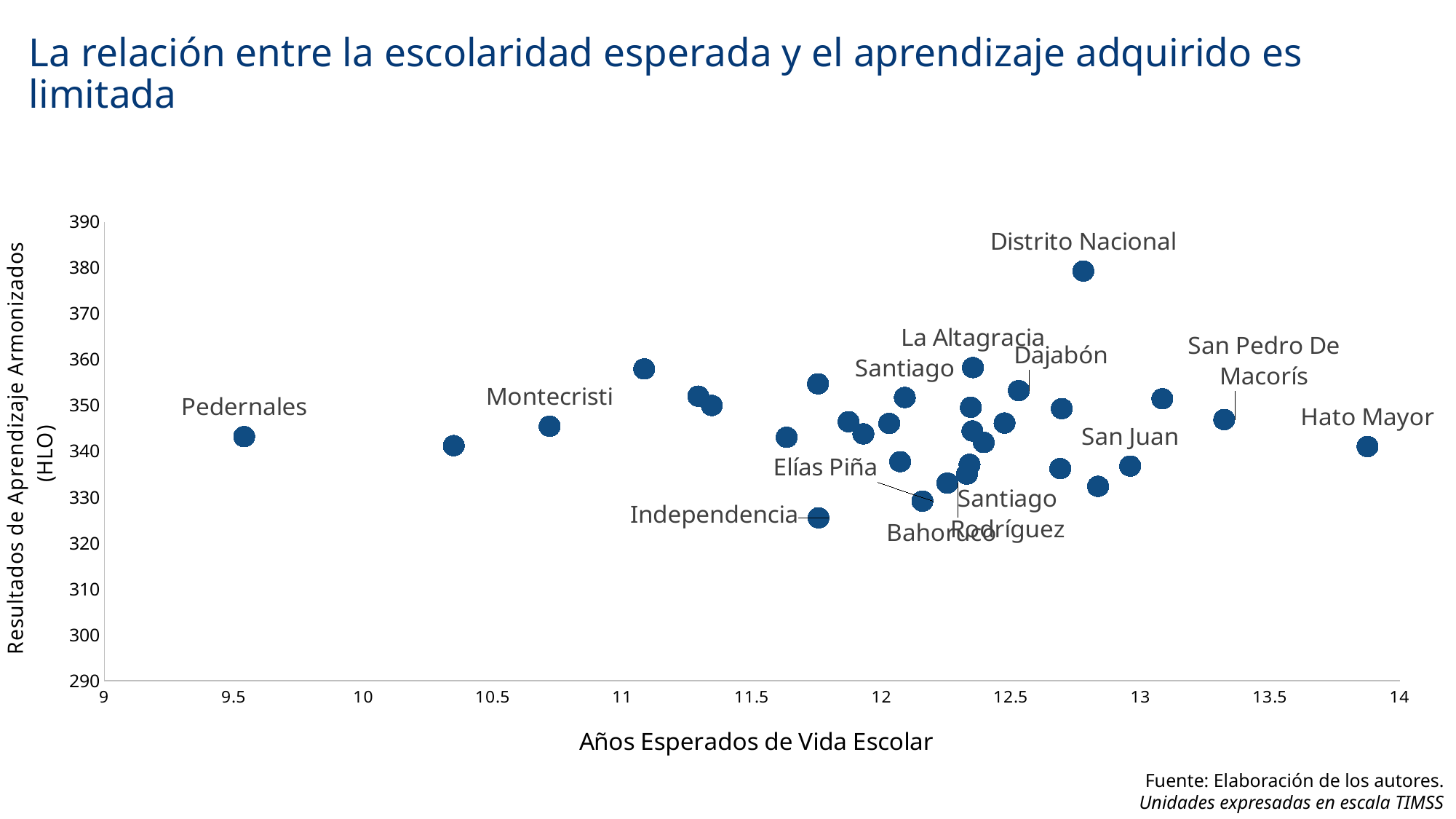
Which labeled province has the lowest Resultados de Aprendizaje Armonizados (HLO) value? Independencia What kind of chart is shown on the slide? scatter chart Which has a higher HLO value, Distrito Nacional or Pedernales? Distrito Nacional Is the Años Esperados de Vida Escolar value for Pedernales greater or less than 10? less Is the HLO value for Distrito Nacional greater or less than 370? greater Which has a higher HLO value, Montecristi or Independencia? Montecristi Is the HLO value for Independencia greater or less than 330? less What is the label of the x axis of the chart? Años Esperados de Vida Escolar Which labeled province has the highest Años Esperados de Vida Escolar value? Hato Mayor Which labeled province has the highest Resultados de Aprendizaje Armonizados (HLO) value? Distrito Nacional